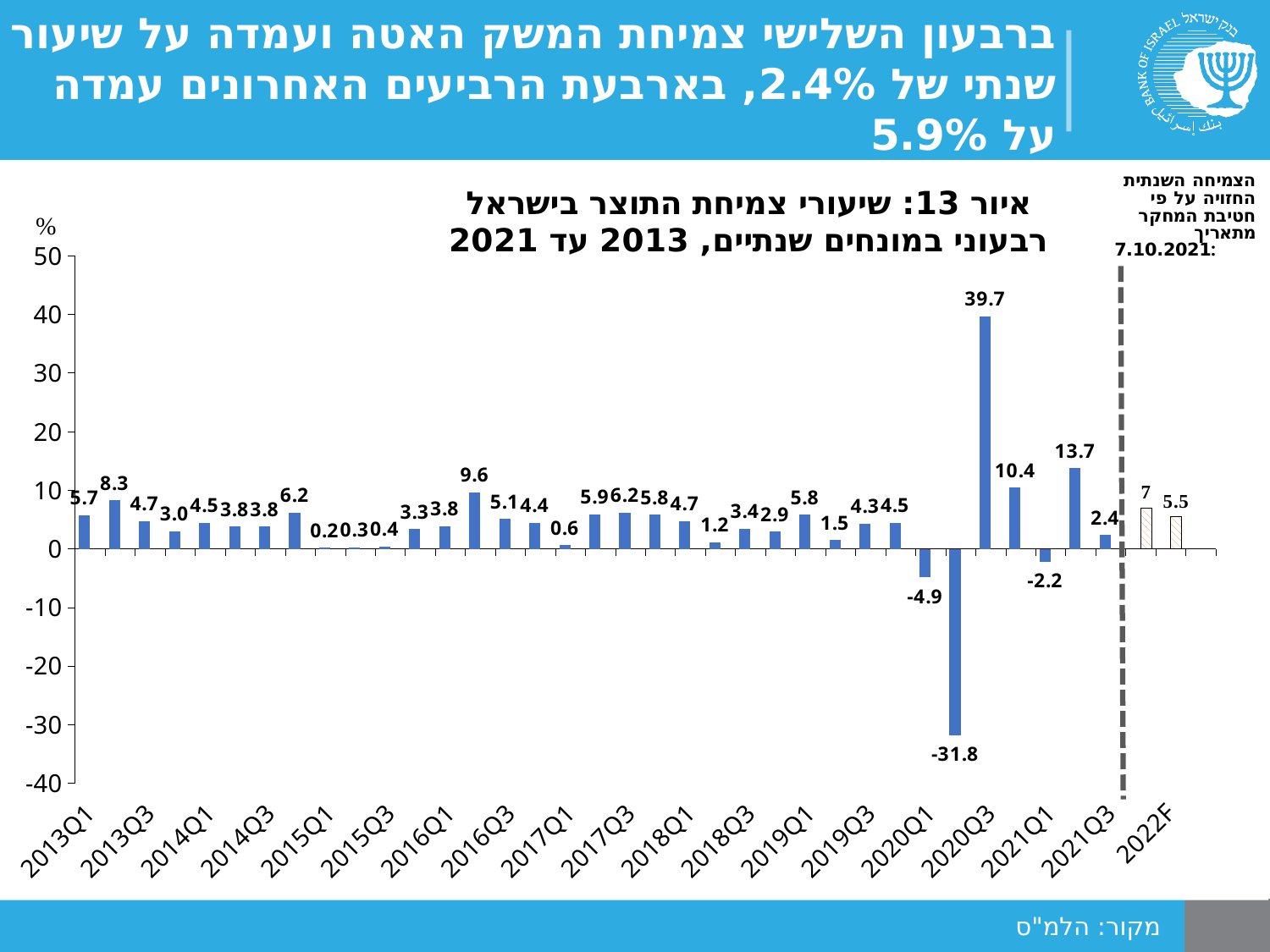
What is the value for 2021Q3? 2.4 What is the difference between the values for 2019Q1 and 2018Q1? 1.1 What is the value for 2020Q3? 39.7 What is the difference between the values for 2020Q3 and 2021Q1? 41.9 What is the lowest value shown on the chart? -31.8 What is the value for 2021Q1? -2.2 What kind of chart is shown on the slide? bar chart What is the value for 2020Q1? -4.9 Which is larger, the value for 2013Q1 or the value for 2013Q3? 2013Q1 Which quarter has the highest growth rate? 2020Q3 Is the value for 2020Q3 greater or less than 30? greater